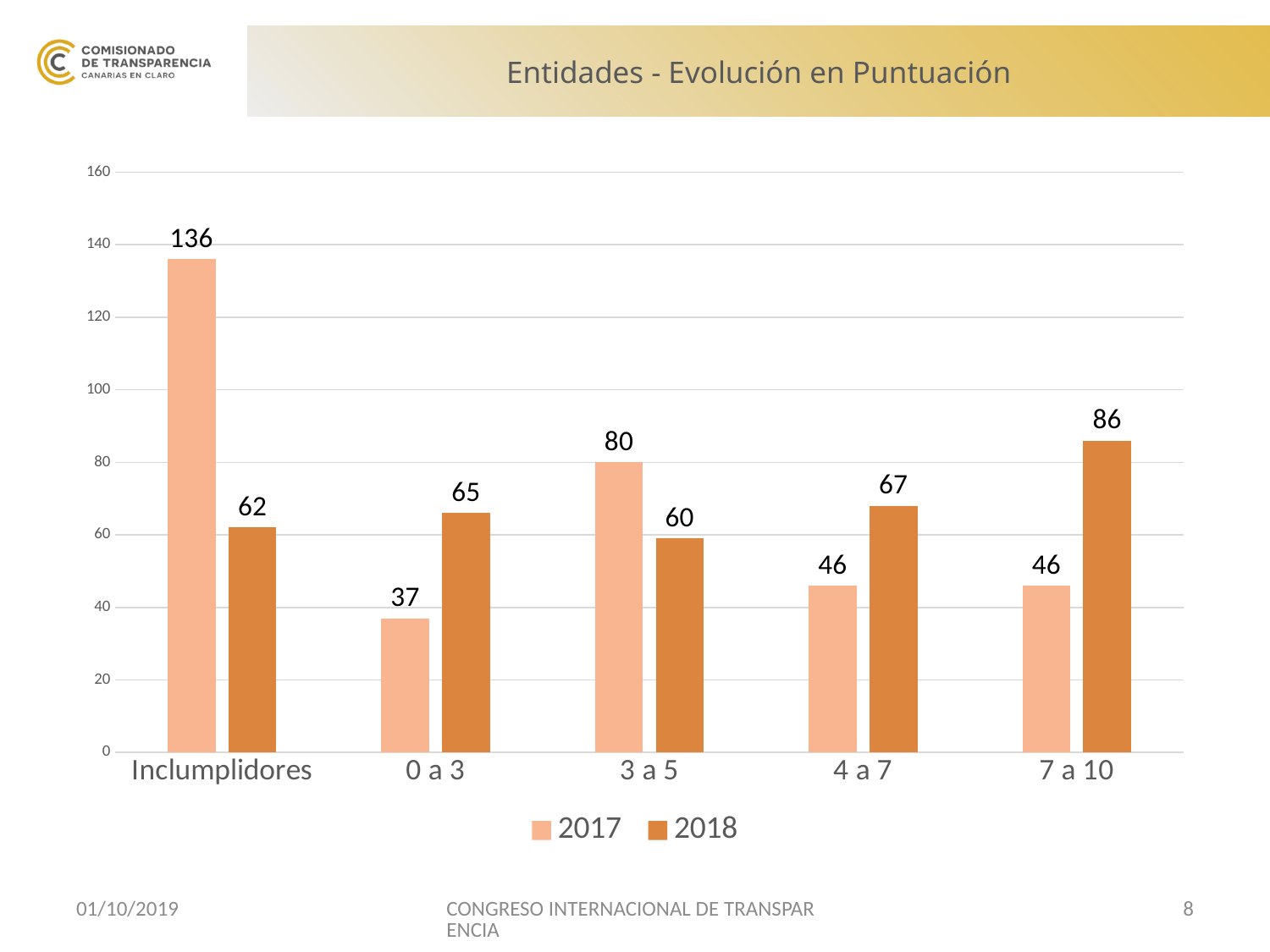
Which category has the highest 2018 value? 7 a 10 How many categories are shown on the x axis? 5 How many series does the legend list? 2 What kind of chart is shown on the slide? Bar chart Which category has the highest 2017 value? Inclumplidores What is the difference between the 2017 and 2018 values for Inclumplidores? 74 What is the 2018 value for 0 a 3? 65 Which category has the lowest 2017 value? 0 a 3 What is the 2018 value for 7 a 10? 86 What is the 2017 value for Inclumplidores? 136 Which is larger for 3 a 5: the 2017 value or the 2018 value? 2017 What is the title of the slide containing the chart? Entidades - Evolución en Puntuación